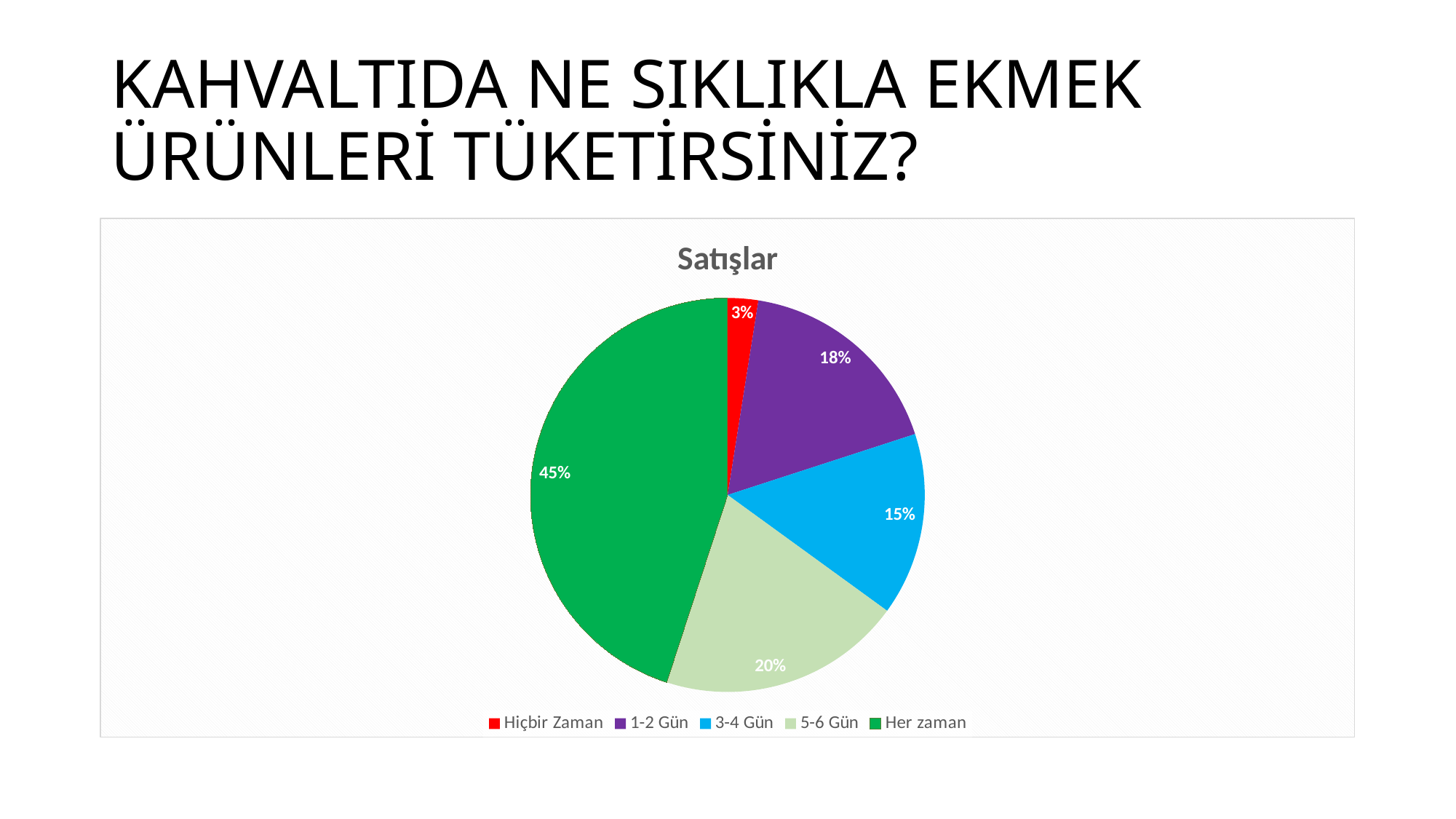
What percentage is shown for the '1-2 Gün' slice? 18% Which category has the largest slice of the pie? Her zaman What is the difference in percentage points between the 'Her zaman' slice and the '5-6 Gün' slice? 25 What percentage is shown for the '5-6 Gün' slice? 20% What percentage is shown for the 'Hiçbir Zaman' slice? 3% What is the chart's title? Satışlar What type of chart is shown on the slide? pie chart How many categories does the legend list? 5 Which category has the smallest slice of the pie? Hiçbir Zaman Which slice is larger, '1-2 Gün' or '3-4 Gün'? 1-2 Gün What percentage is shown for the '3-4 Gün' slice? 15% What percentage is shown for the 'Her zaman' slice? 45%